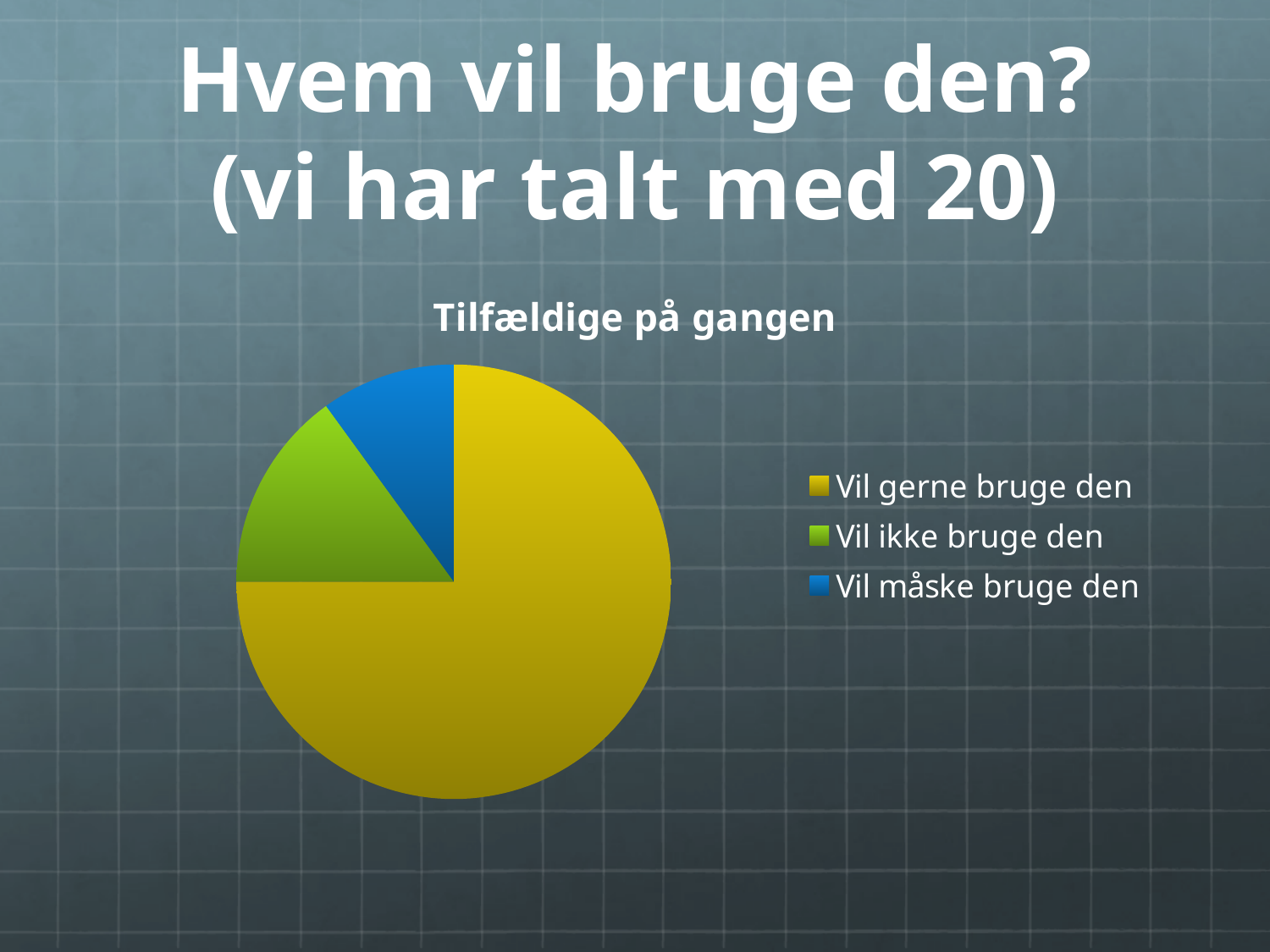
How many slices does the pie chart have? 3 What is the title of the chart? Tilfældige på gangen Which slice is larger: Vil gerne bruge den or Vil ikke bruge den? Vil gerne bruge den Which category has the smallest slice of the pie? Vil måske bruge den Which category has the largest slice of the pie? Vil gerne bruge den How many entries does the legend list? 3 Which colour represents Vil måske bruge den in the pie chart? blue Does the slice for Vil gerne bruge den make up more or less than half of the pie? more What kind of chart is shown on the slide? pie chart Which slice is larger: Vil ikke bruge den or Vil måske bruge den? Vil ikke bruge den